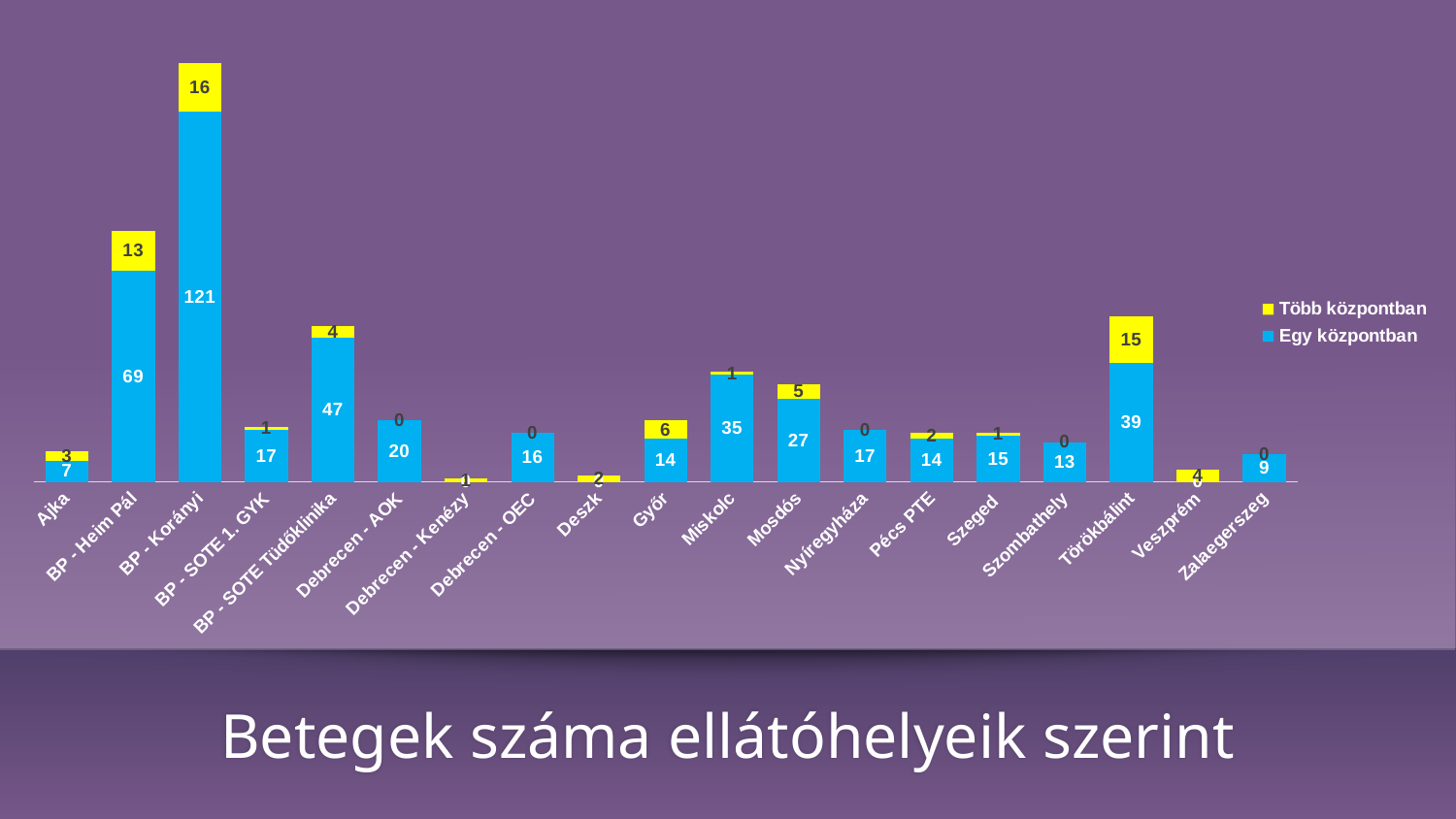
What is the total of the stacked bar for BP - Heim Pál? 82 What is the Több központban value for Törökbálint? 15 What is the Több központban value for Győr? 6 What is the difference between the Egy központban values for BP - SOTE Tüdőklinika and Debrecen - AOK? 27 How many categories are shown on the x axis? 19 What kind of chart is shown on the slide? Stacked bar chart What is the title of the slide? Betegek száma ellátóhelyeik szerint Which is larger, the Egy központban value for Mosdós or for Nyíregyháza? Mosdós What is the Egy központban value for BP - Korányi? 121 Which category has the highest Egy központban value? BP - Korányi How many series does the legend list? 2 What is the Egy központban value for Miskolc? 35